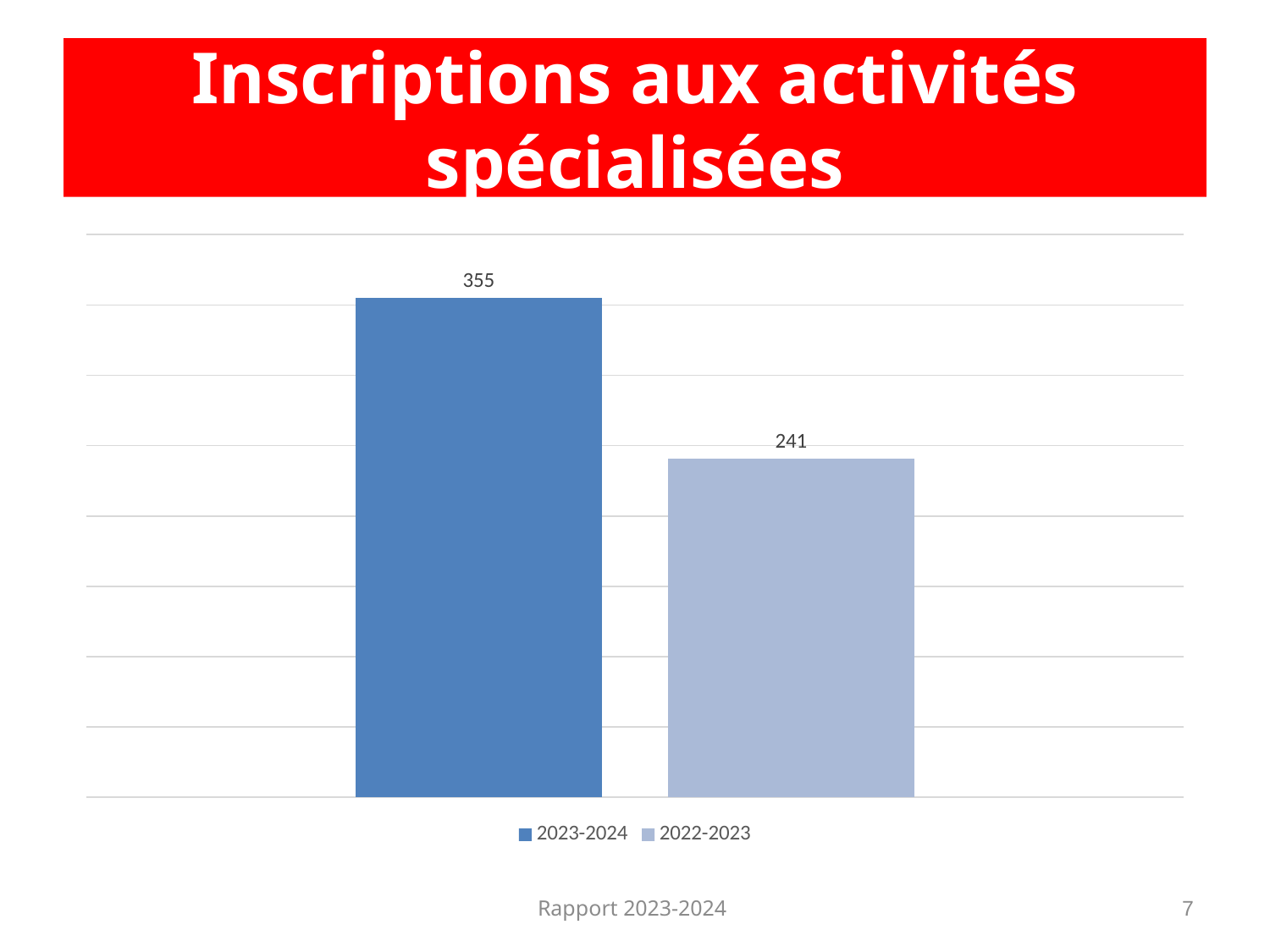
What is the title of the chart? Inscriptions aux activités spécialisées Which series is shown in the darker blue colour? 2023-2024 What kind of chart is shown on the slide? bar chart Which series has the highest value? 2023-2024 Which is larger, the value for 2023-2024 or the value for 2022-2023? 2023-2024 How many series does the legend list? 2 What is the difference between the 2023-2024 value and the 2022-2023 value? 114 What is the value for 2023-2024? 355 Which series has the lowest value? 2022-2023 How many bars are plotted on the chart? 2 What is the value for 2022-2023? 241